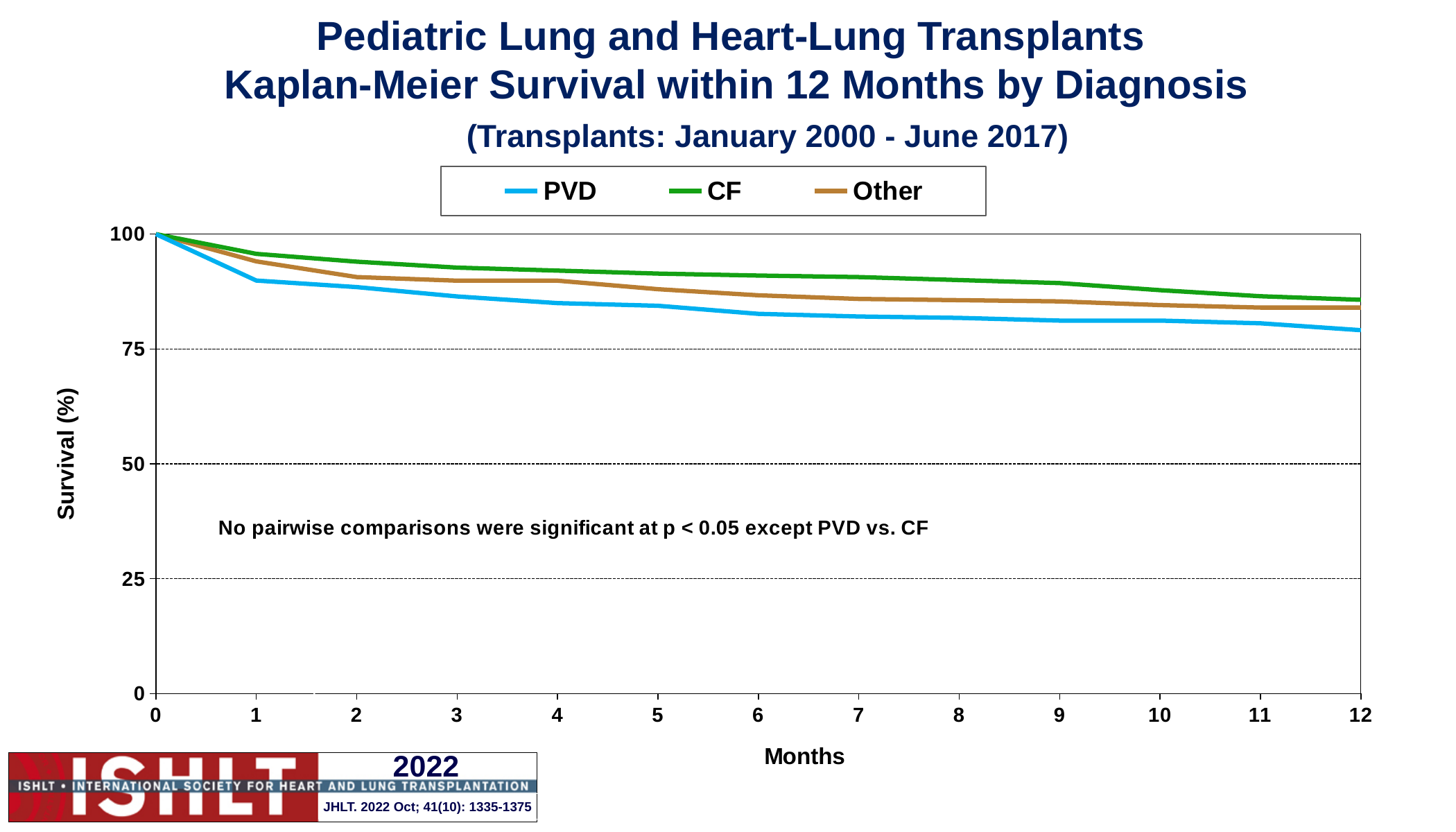
What is the survival value for all three series at month 0? 100 Is the survival for Other at month 6 greater or less than 75? greater What kind of chart is shown on the slide? line chart Which series are listed in the legend? PVD, CF, Other At month 6, which series has higher survival, CF or PVD? CF Is the survival for PVD at month 12 greater or less than 75? greater What is the label of the y axis? Survival (%) Which series has the lowest survival at month 12? PVD Which series has the highest survival at month 12? CF Do the survival curves rise or fall as months increase? fall Is the survival for CF at month 12 greater or less than 100? less How many series does the legend list? 3